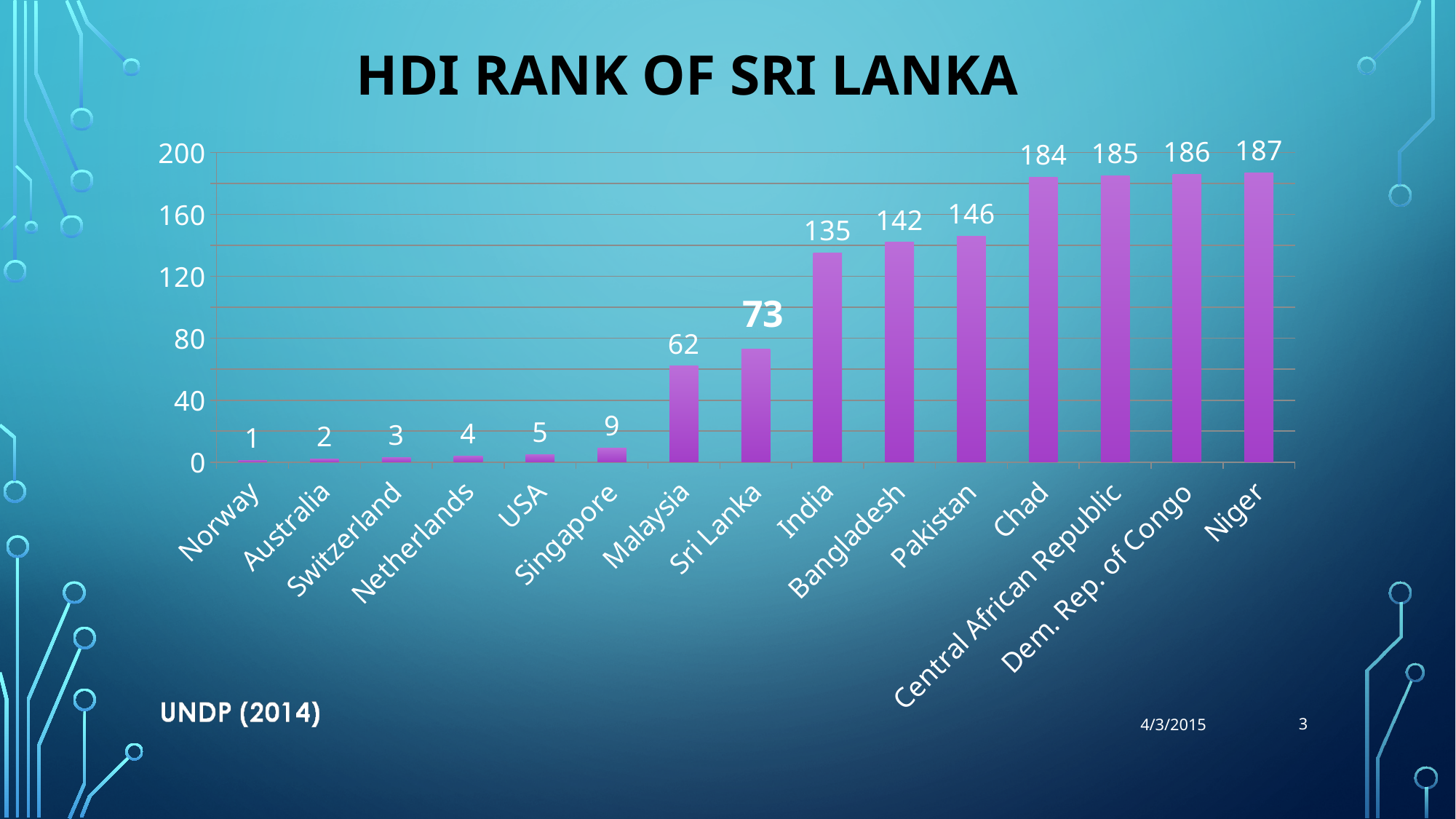
What is the value shown for India? 135 What is the HDI rank shown for Sri Lanka? 73 Do the values rise or fall from left to right along the x axis? rise Is the value for Chad greater or less than 160? greater Which country has the highest value in the chart? Niger How many countries are shown in the chart? 15 What kind of chart is shown on the slide? bar chart Which country has the lowest value in the chart? Norway What is the value shown for Singapore? 9 What is the difference between the values for Bangladesh and India? 7 Which has a larger value, Malaysia or Sri Lanka? Sri Lanka What is the difference between the values for Pakistan and Sri Lanka? 73